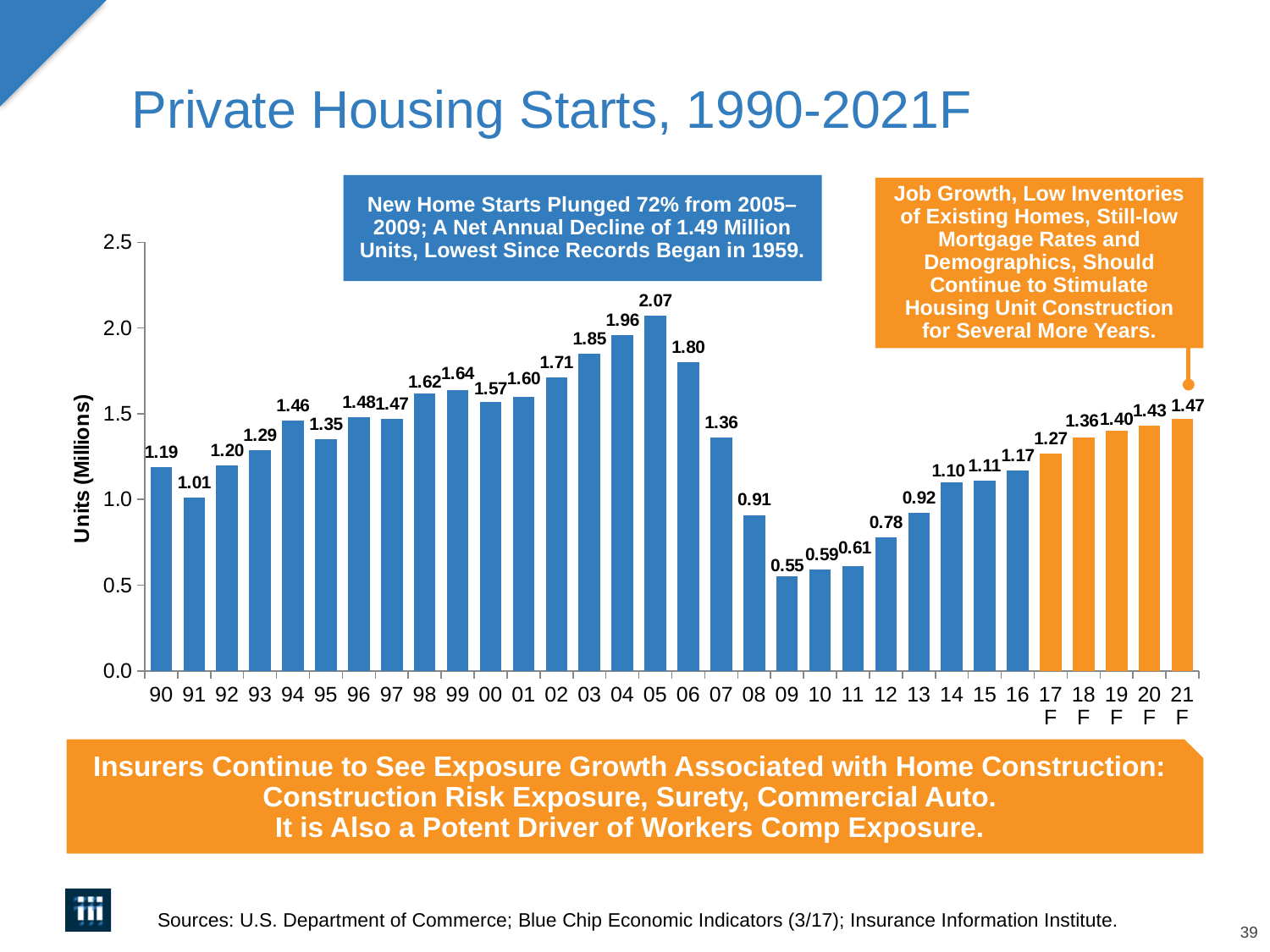
Which year has the highest value in the Private Housing Starts chart? 05 Which is larger in the Private Housing Starts chart, the value for 2006 (06) or the value for 2007 (07)? 06 What is the label on the vertical axis of the Private Housing Starts chart? Units (Millions) What is the forecast value for 2021F in the Private Housing Starts chart? 1.47 What kind of chart is shown on the slide? Bar chart What is the value for 2005 (05) in the Private Housing Starts chart? 2.07 Which year has the lowest value in the Private Housing Starts chart? 09 What is the value for 2009 (09) in the Private Housing Starts chart? 0.55 What is the difference between the 2005 (05) value and the 2009 (09) value in the Private Housing Starts chart? 1.52 Is the value for 2012 (12) in the Private Housing Starts chart greater or less than 1.0? less Do the values in the Private Housing Starts chart rise or fall from 2009 (09) to 2016 (16)? Rise How many bars (years) are plotted in the Private Housing Starts chart? 32